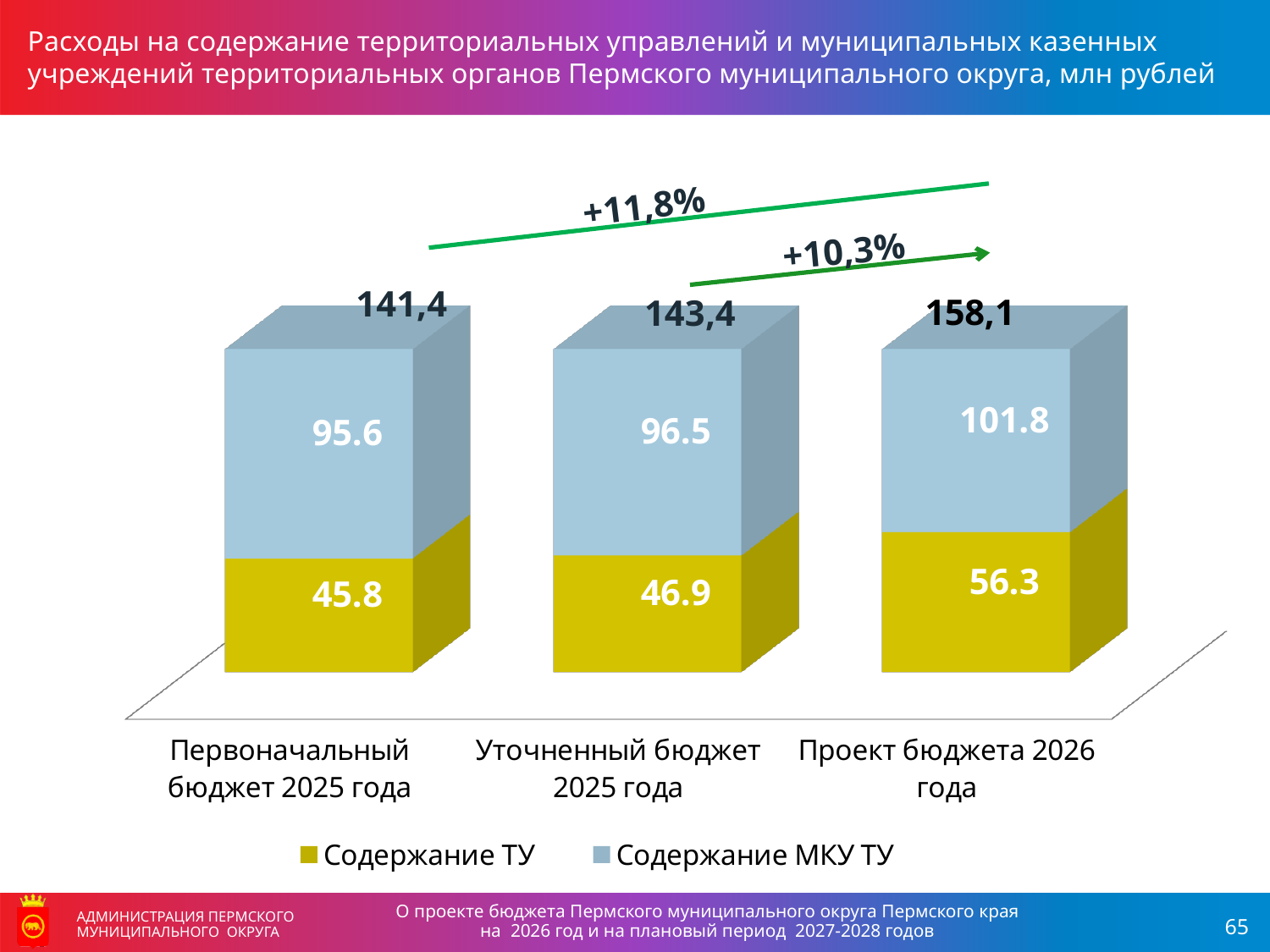
Which is larger: Содержание МКУ ТУ for Уточненный бюджет 2025 года or Содержание ТУ for Проект бюджета 2026 года? Содержание МКУ ТУ for Уточненный бюджет 2025 года What is the value of Содержание МКУ ТУ for Уточненный бюджет 2025 года? 96.5 What is the value of Содержание ТУ for Первоначальный бюджет 2025 года? 45.8 What kind of chart is shown on the slide? Stacked bar chart What is the total of the stacked bar for Проект бюджета 2026 года? 158,1 What is the total of the stacked bar for Первоначальный бюджет 2025 года? 141,4 Which category has the lowest value for Содержание МКУ ТУ? Первоначальный бюджет 2025 года How many series does the legend list? 2 How many categories are shown on the x axis? 3 What is the difference between Содержание ТУ for Проект бюджета 2026 года and for Уточненный бюджет 2025 года? 9.4 Which category has the highest value for Содержание ТУ? Проект бюджета 2026 года What is the value of Содержание МКУ ТУ for Проект бюджета 2026 года? 101.8